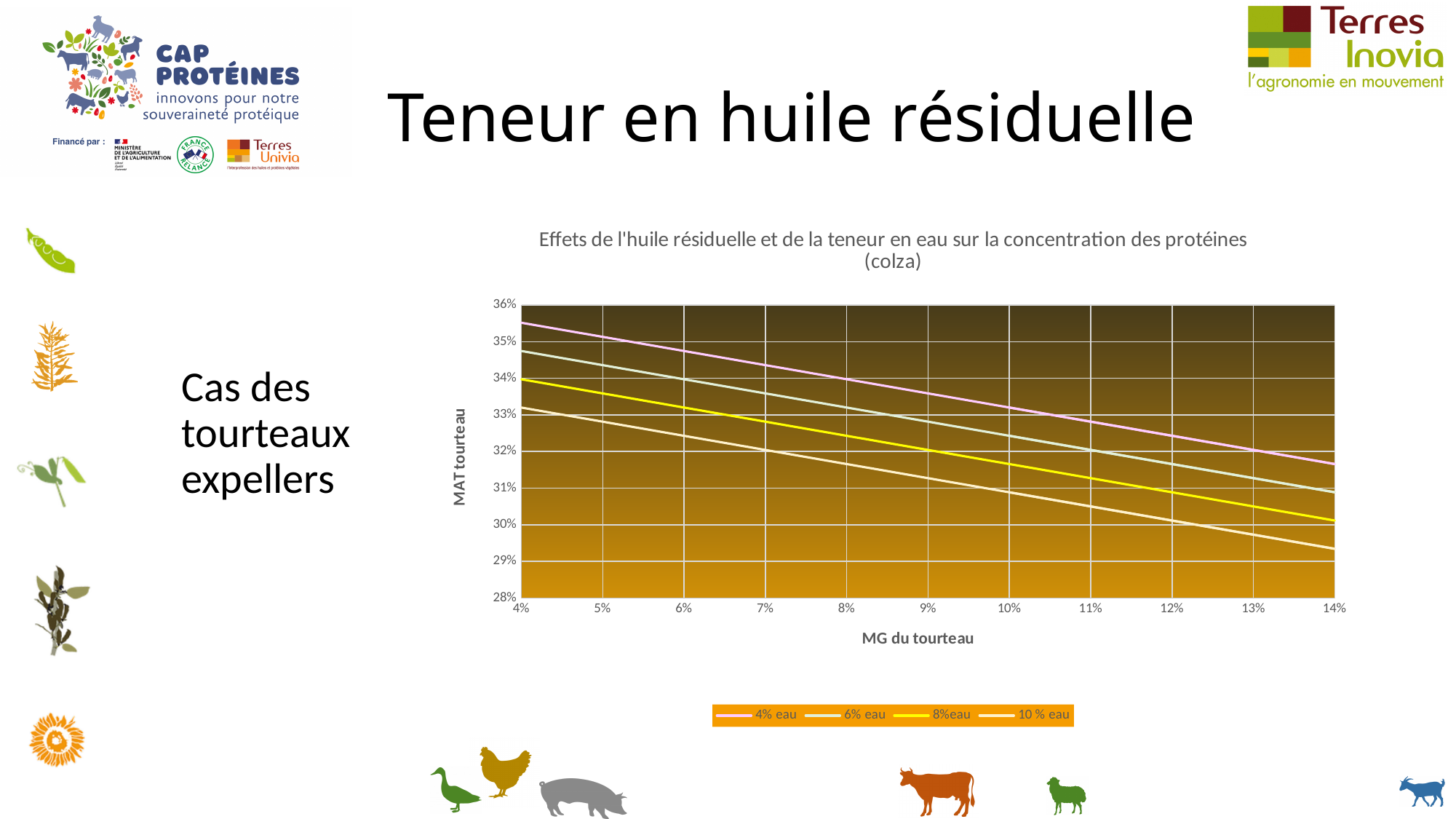
Which series has the highest MAT tourteau values across the whole range of MG du tourteau? 4% eau What kind of chart is shown on the slide? line chart Is the MAT tourteau value for the 4% eau series at 4% MG du tourteau greater or less than 35%? greater Is the MAT tourteau value for the 6% eau series at 4% MG du tourteau greater or less than 34%? greater What is the label of the y axis of the chart? MAT tourteau Which series has the lowest MAT tourteau values across the whole range of MG du tourteau? 10 % eau Is the MAT tourteau value for the 10 % eau series at 14% MG du tourteau greater or less than 30%? less How many MG du tourteau tick values are labelled on the x axis? 11 How many series does the legend list? 4 Do the MAT tourteau values rise or fall as MG du tourteau increases from 4% to 14%? fall At 14% MG du tourteau, which series has the larger MAT tourteau value, 4% eau or 10 % eau? 4% eau